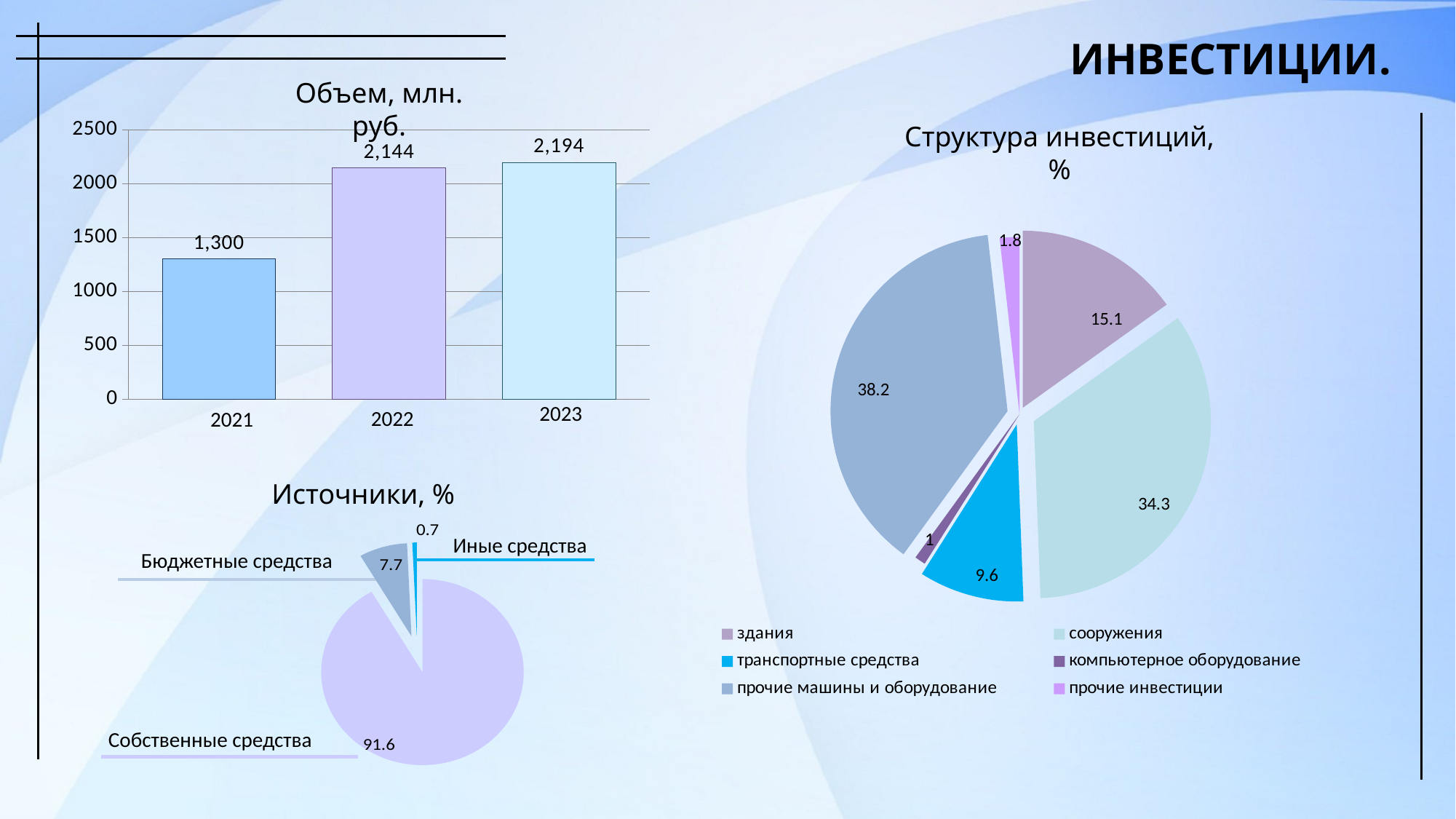
In the chart titled "Источники, %", what is the value for Бюджетные средства? 7.7 In the chart titled "Структура инвестиций, %", what is the value for транспортные средства? 9.6 What kind of chart is the one titled "Объем, млн. руб."? bar chart In the chart titled "Объем, млн. руб.", do the values rise or fall from 2021 to 2023? rise In the chart titled "Структура инвестиций, %", which category has the largest slice? прочие машины и оборудование In the chart titled "Источники, %", which category has the largest share? Собственные средства In the chart titled "Структура инвестиций, %", which is larger: здания or сооружения? сооружения In the chart titled "Объем, млн. руб.", which year has the lowest value? 2021 In the chart titled "Структура инвестиций, %", how many categories does the legend list? 6 In the chart titled "Объем, млн. руб.", what is the difference between the values for 2023 and 2021? 894 In the chart titled "Объем, млн. руб.", how many years are shown? 3 In the chart titled "Объем, млн. руб.", what is the value for 2022? 2,144